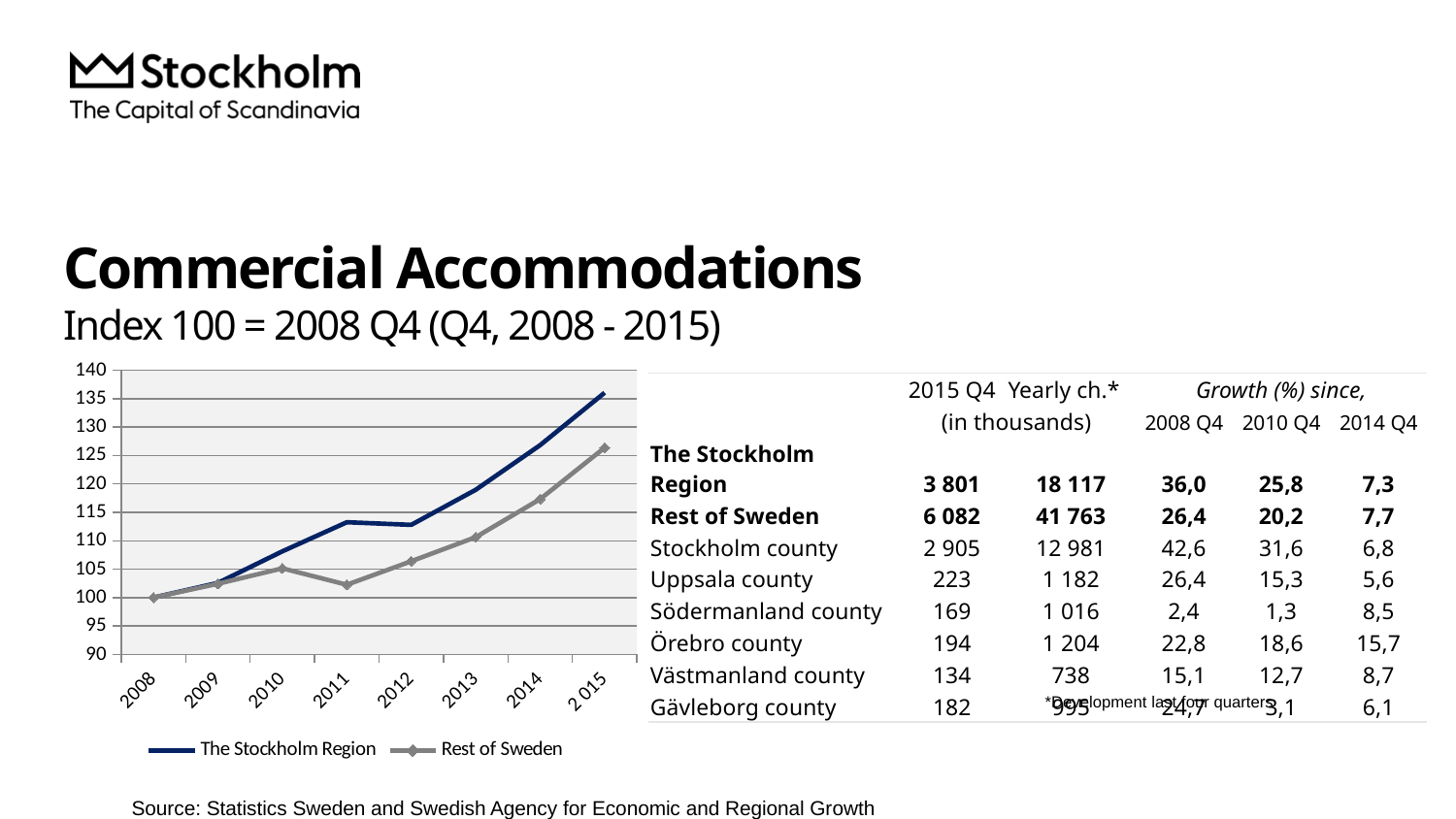
In which year is the Rest of Sweden series at its lowest value? 2008 Which series has the higher value in 2015, The Stockholm Region or Rest of Sweden? The Stockholm Region What is the index value for Rest of Sweden in 2008? 100 How many years are plotted along the x axis of the chart? 8 What kind of chart is shown on the slide? line chart Is the value for Rest of Sweden in 2015 greater or less than 130? less In which year does The Stockholm Region series reach its highest value? 2015 Is the value for The Stockholm Region in 2011 greater or less than 110? greater What is the index value for The Stockholm Region in 2008? 100 Does The Stockholm Region series generally rise or fall from 2008 to 2015? rise How many series does the chart legend list? 2 Is the value for The Stockholm Region in 2015 greater or less than 130? greater